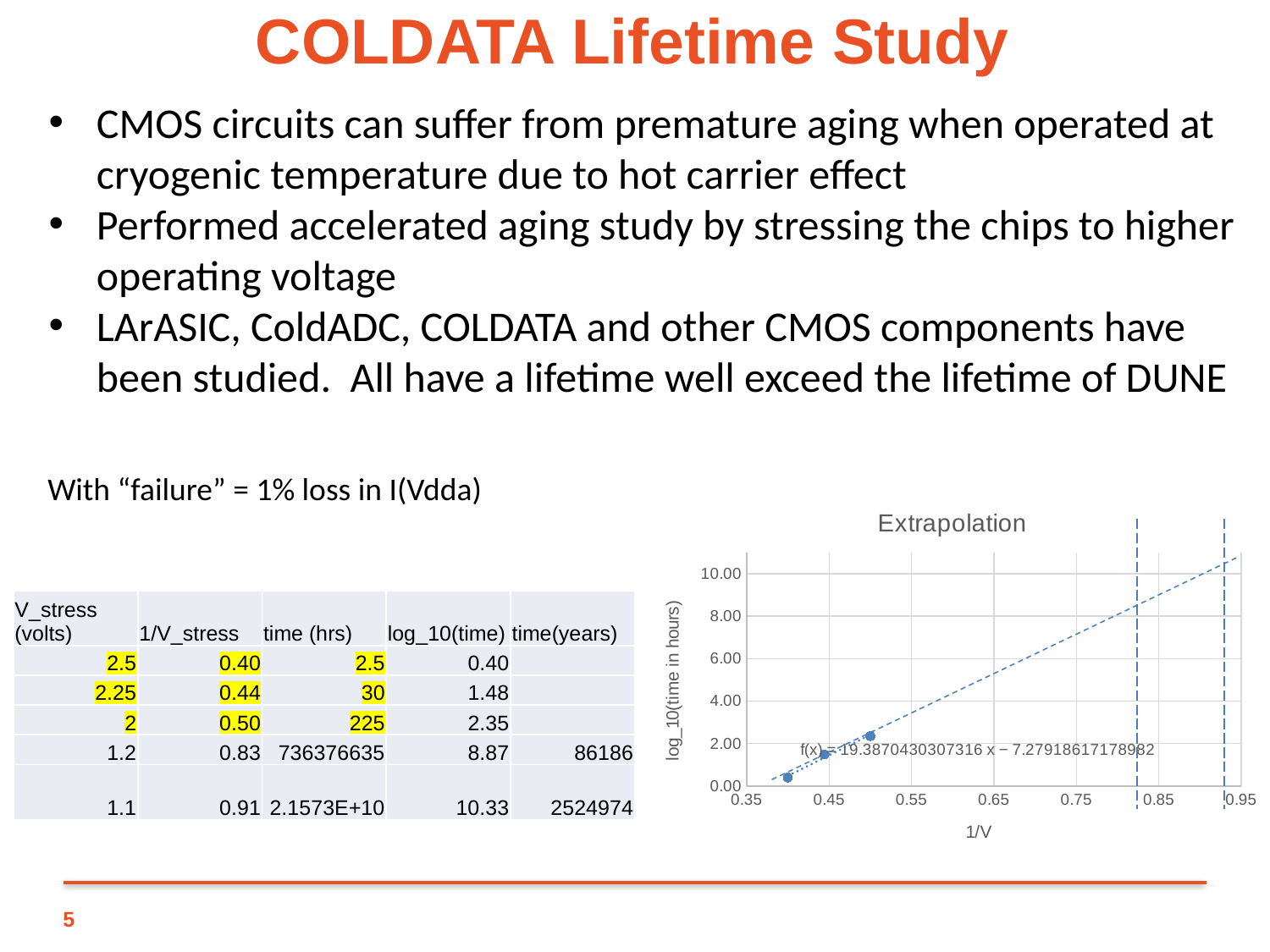
What is the trendline equation shown on the "Extrapolation" chart? f(x) = 19.3870430307316 x − 7.27918617178982 What is the title of the chart on the slide? Extrapolation In the "Extrapolation" chart, which plotted point has the lowest log_10(time in hours) value? The point at 1/V = 0.40 In the "Extrapolation" chart, do the plotted values rise or fall as 1/V increases? Rise What kind of chart is the "Extrapolation" chart? Scatter chart In the "Extrapolation" chart, is the log_10(time in hours) value for the point at 1/V = 0.50 greater or less than 4.00? less In the "Extrapolation" chart, is the log_10(time in hours) value for the point at 1/V = 0.40 greater or less than 2.00? less How many data points are plotted in the "Extrapolation" chart? 3 What is the highest tick value shown on the y axis of the "Extrapolation" chart? 10.00 In the "Extrapolation" chart, is the log_10(time in hours) value for the point at 1/V = 0.50 greater or less than 2.00? greater In the "Extrapolation" chart, which plotted point has the highest log_10(time in hours) value? The point at 1/V = 0.50